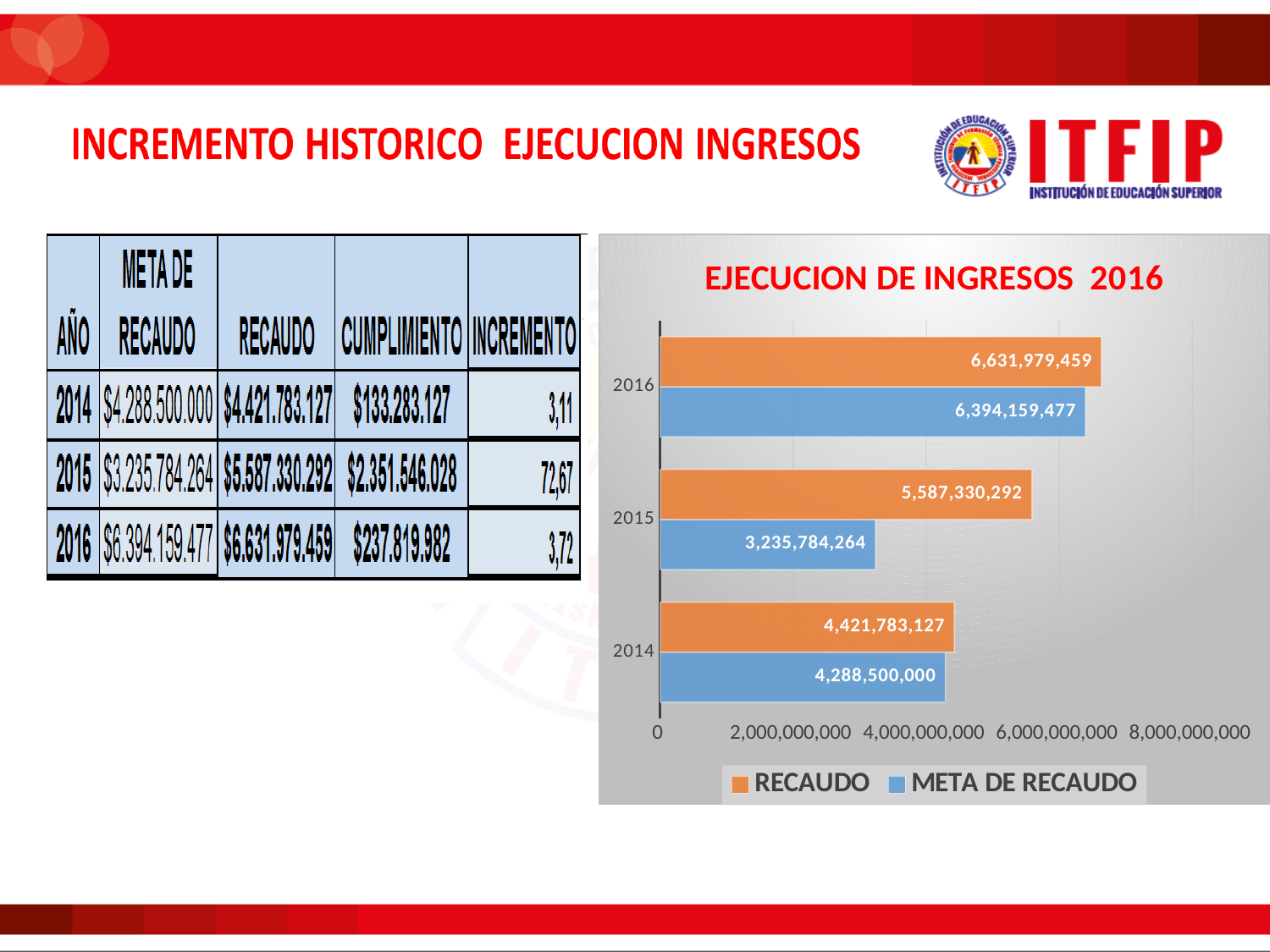
What is the title of the chart? EJECUCION DE INGRESOS 2016 How many series does the chart legend list? 2 Which year has the lowest META DE RECAUDO value? 2015 How many years are shown in the chart? 3 Is the META DE RECAUDO value for 2016 greater or less than 6,000,000,000? greater What is the META DE RECAUDO value for 2015 in the chart? 3,235,784,264 What is the RECAUDO value for 2016 in the chart? 6,631,979,459 What is the META DE RECAUDO value for 2014 in the chart? 4,288,500,000 What type of chart is shown on the slide? bar chart Which year has the highest RECAUDO value? 2016 What is the difference between RECAUDO and META DE RECAUDO for 2015? 2,351,546,028 Which is larger for 2014, RECAUDO or META DE RECAUDO? RECAUDO